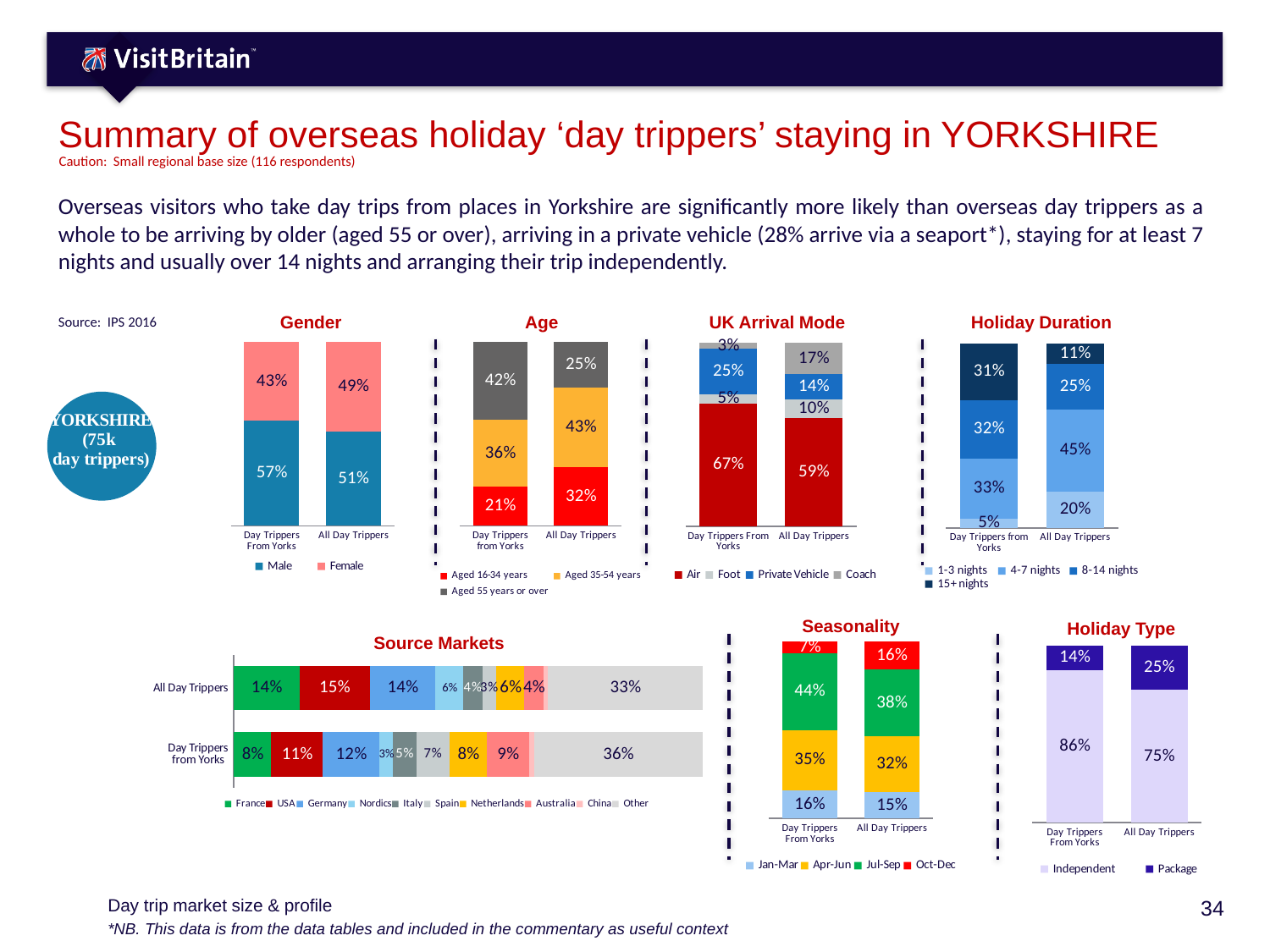
In the Source Markets chart, what share of Day Trippers from Yorks come from Germany? 12% In the Holiday Type chart, what percentage of Day Trippers From Yorks travel Independent? 86% How many series does the legend of the Seasonality chart list? 4 In the Holiday Duration chart, which duration has the smallest share for Day Trippers from Yorks? 1-3 nights In the Gender chart, what percentage of Day Trippers From Yorks are male? 57% In the UK Arrival Mode chart, which arrival mode has the largest share for All Day Trippers? Air In the Seasonality chart, is the Oct-Dec share larger for Day Trippers From Yorks or for All Day Trippers? All Day Trippers In the Age chart, what share of Day Trippers from Yorks are aged 55 years or over? 42% In the Age chart, what is the difference between the Aged 35-54 years share for All Day Trippers and for Day Trippers from Yorks? 7% In the Holiday Duration chart, what percentage of Day Trippers from Yorks stay 15+ nights? 31% In the Seasonality chart, which quarter has the highest share for Day Trippers From Yorks? Jul-Sep In the UK Arrival Mode chart, what percentage of Day Trippers From Yorks arrive by Private Vehicle? 25%